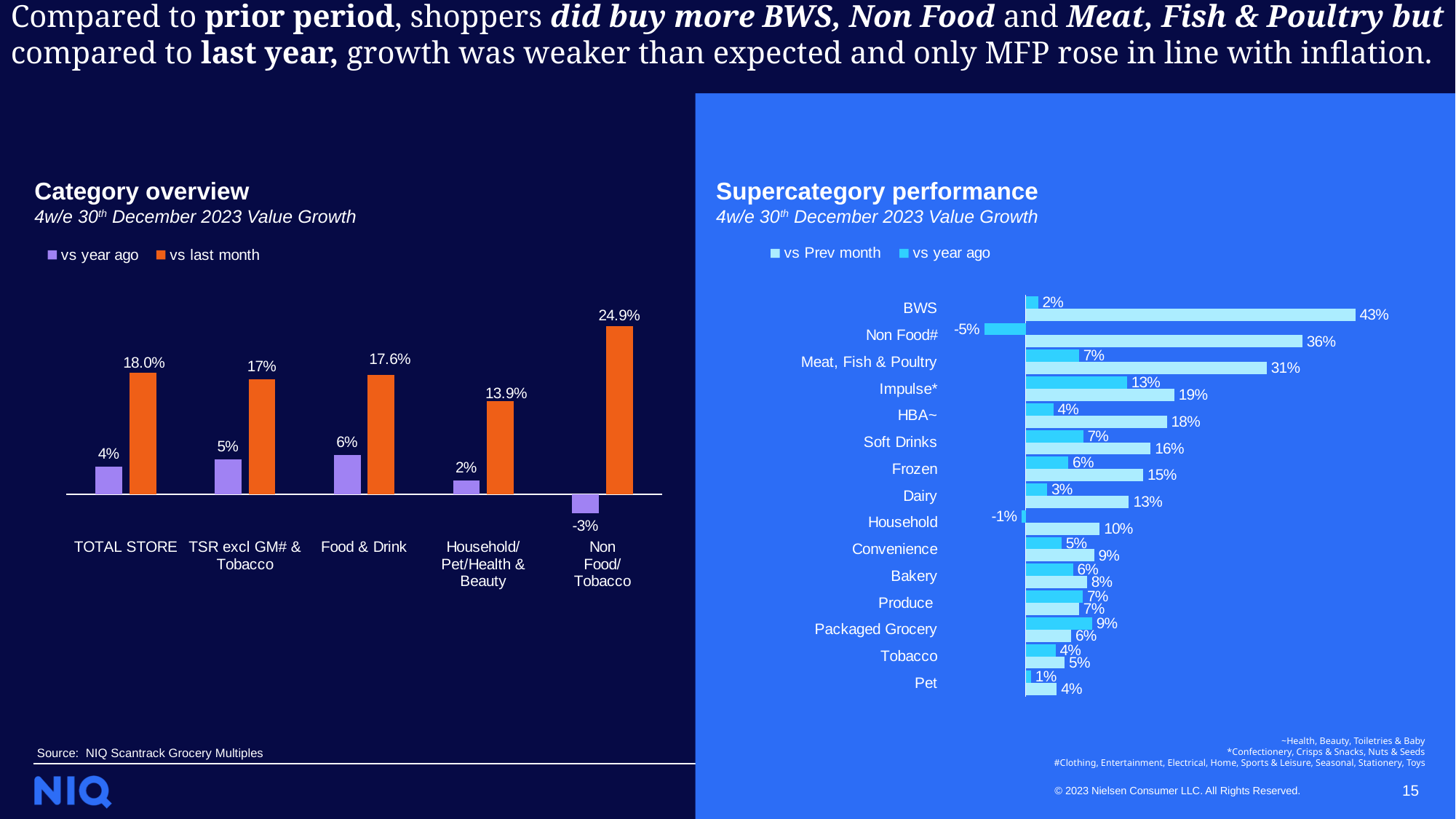
In the Category overview chart, what is the vs year ago value for Food & Drink? 6% In the Supercategory performance chart, how many categories are listed? 15 In the Supercategory performance chart, what is the vs Prev month value for BWS? 43% In the Category overview chart, how many categories are shown on the x axis? 5 What type of chart is the Category overview chart? Bar chart How many series does the legend of the Supercategory performance chart list? 2 In the Supercategory performance chart, which is larger for Packaged Grocery: the vs Prev month value or the vs year ago value? vs year ago In the Category overview chart, which category has the lowest vs year ago value? Non Food/Tobacco In the Supercategory performance chart, which category has the highest vs Prev month value? BWS In the Supercategory performance chart, what is the vs year ago value for Non Food#? -5% In the Category overview chart, what is the difference between the vs last month and vs year ago values for TOTAL STORE? 14.0% In the Category overview chart, what is the vs last month value for Non Food/Tobacco? 24.9%